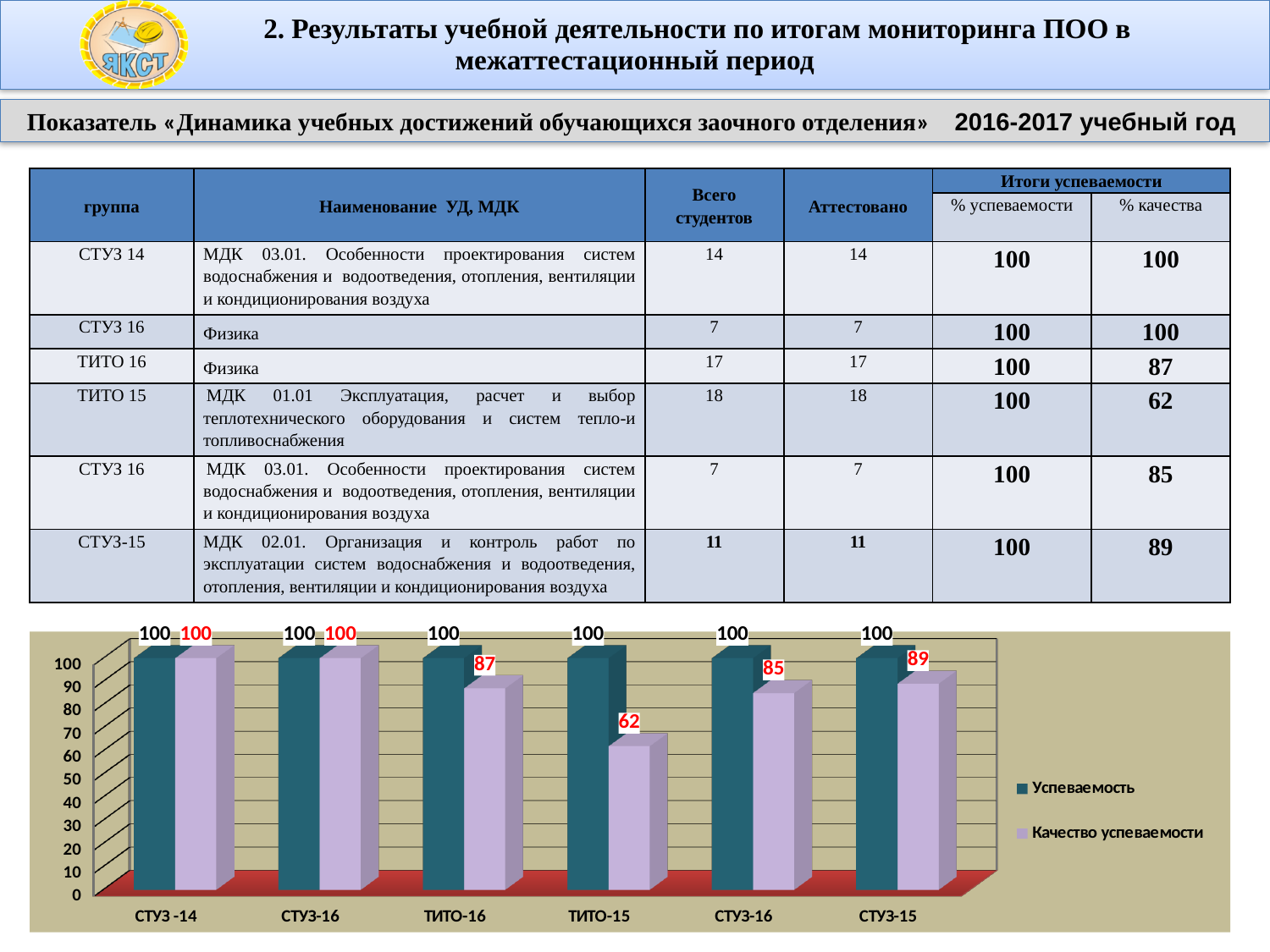
For СТУЗ-15, how much higher is Успеваемость than Качество успеваемости? 11 How many series does the chart legend list? 2 What is the value of Качество успеваемости for СТУЗ-15 in the chart? 89 Which series in the chart is shown in teal (dark green-blue)? Успеваемость What is the difference between the Качество успеваемости values for ТИТО-16 and ТИТО-15? 25 How many categories are shown on the x axis of the chart? 6 What type of chart is shown at the bottom of the slide? bar chart Which has the larger Качество успеваемости value: ТИТО-16 or СТУЗ-15? СТУЗ-15 Which category has the lowest Качество успеваемости value in the chart? ТИТО-15 What is the value of Качество успеваемости for ТИТО-15 in the chart? 62 What is the value of Качество успеваемости for ТИТО-16 in the chart? 87 What is the value of Успеваемость for ТИТО-15 in the chart? 100